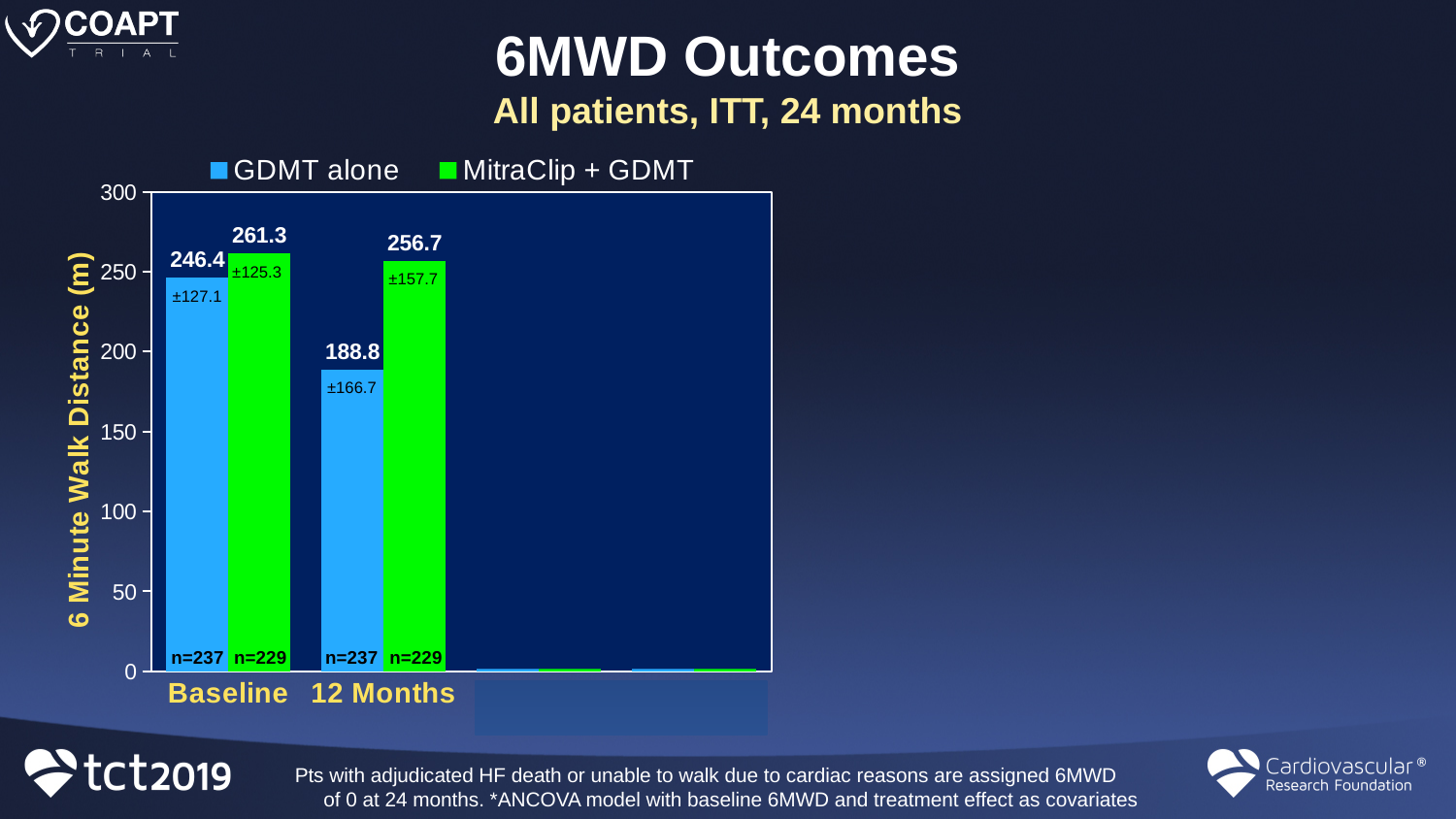
Which bar has the highest value on the chart? MitraClip + GDMT at Baseline Which bar has the lowest value on the chart? GDMT alone at 12 Months At 12 Months, which is larger: GDMT alone or MitraClip + GDMT? MitraClip + GDMT What is the difference between the GDMT alone values at Baseline and 12 Months? 57.6 What is the value for GDMT alone at Baseline? 246.4 What kind of chart is shown on the slide? bar chart How many series does the legend list? 2 What is the value for MitraClip + GDMT at 12 Months? 256.7 What is the value for GDMT alone at 12 Months? 188.8 What is the value for MitraClip + GDMT at Baseline? 261.3 Does the value for GDMT alone at 12 Months rise or fall compared with Baseline? fall What is the difference between MitraClip + GDMT and GDMT alone at 12 Months? 67.9